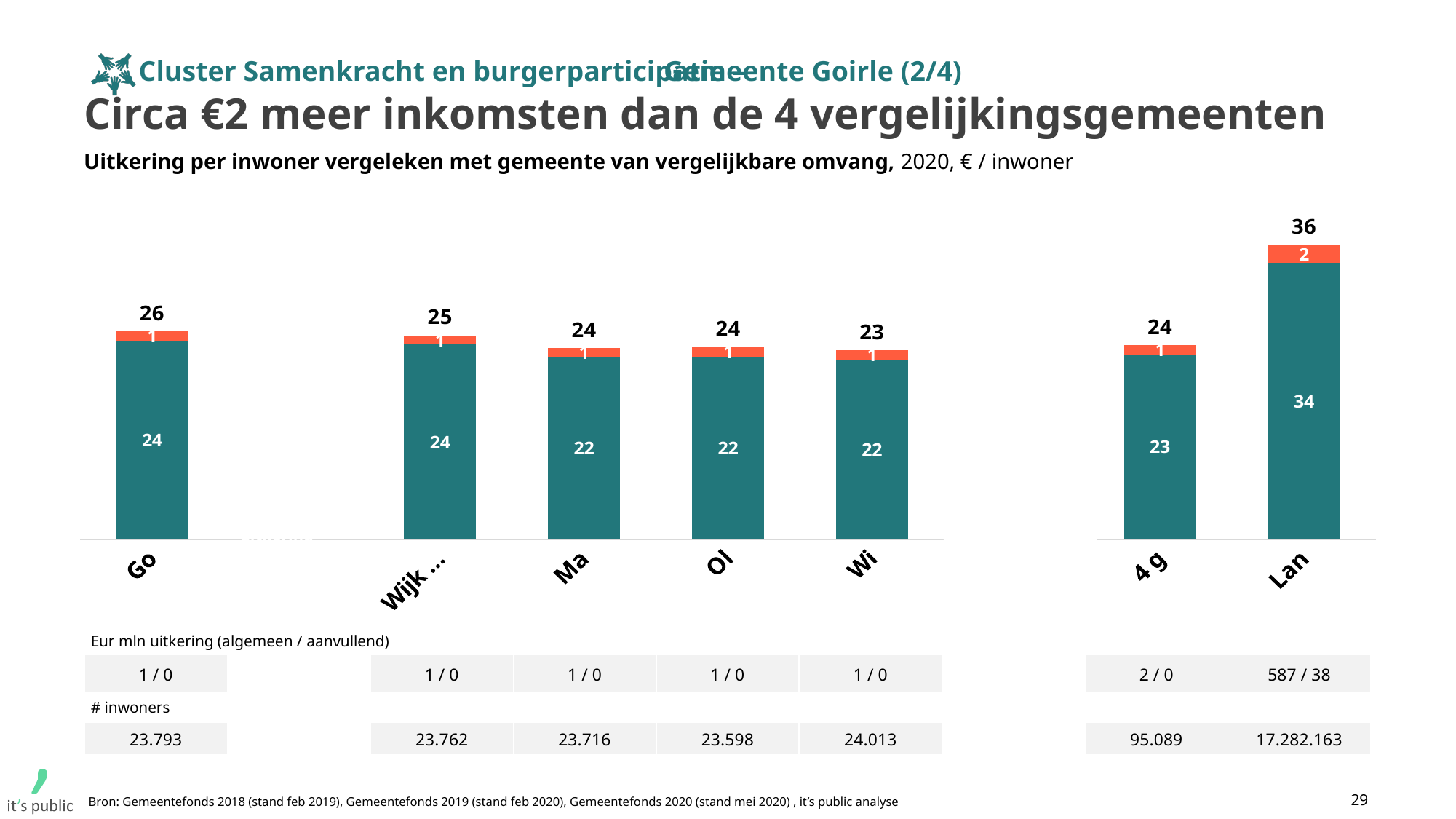
What is the total value printed above the bar for Lan? 36 What is the difference between the total for Go and the total for 4 g? 2 What is the total value printed above the bar for Go? 26 What is the value of the teal (lower) segment of the 4 g bar? 23 What is the value of the orange (upper) segment of the Lan bar? 2 Which category has the highest total bar? Lan Which category has the lowest total bar? Wi What is the difference between the total for Lan and the total for Go? 10 What kind of chart is shown on the slide? Stacked bar chart Which has a higher total, Go or Wijk ...? Go How many bars are plotted in the chart? 7 What is the value of the teal (lower) segment of the Lan bar? 34